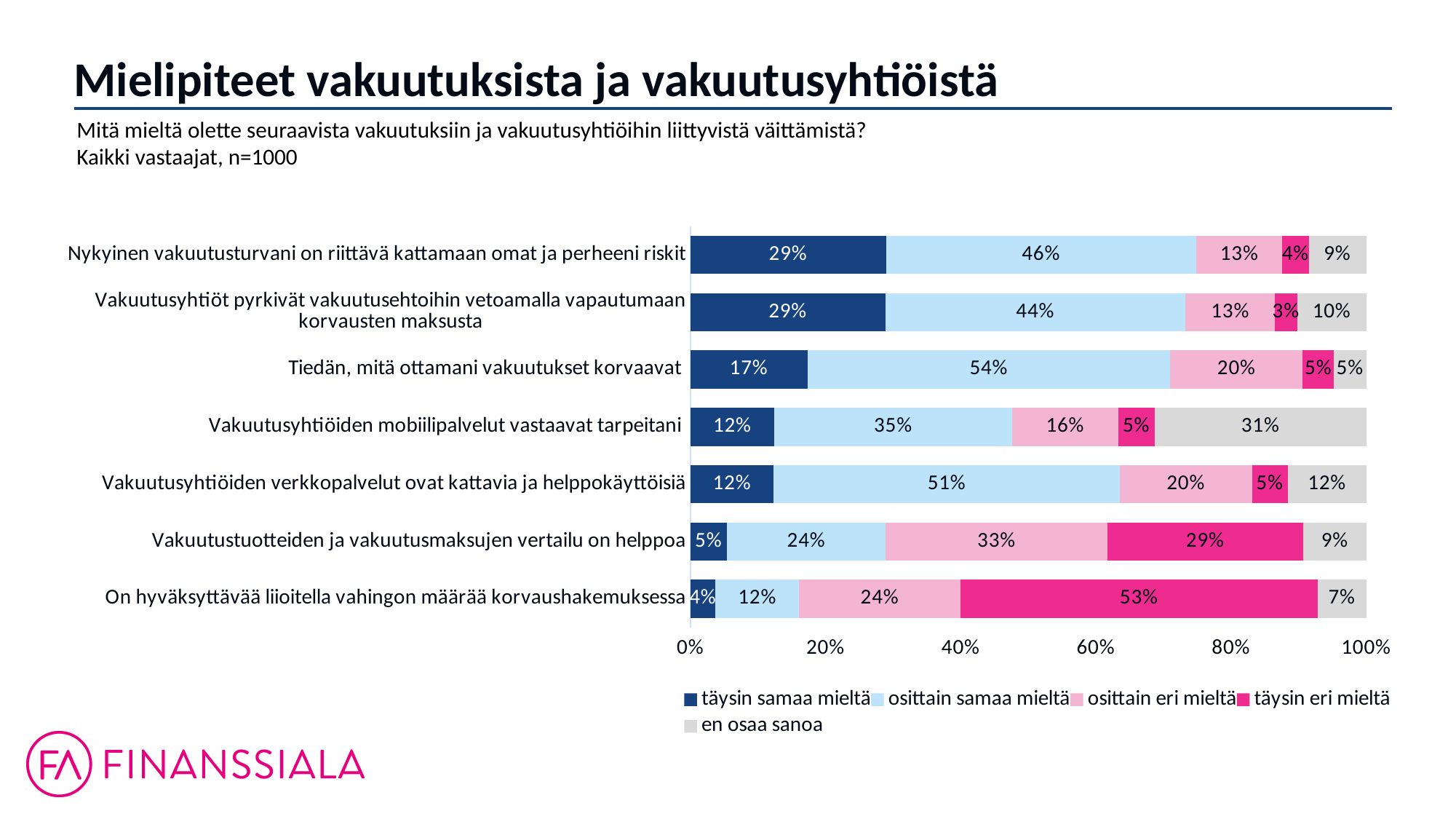
What is the 'osittain samaa mieltä' value for 'Vakuutusyhtiöiden verkkopalvelut ovat kattavia ja helppokäyttöisiä'? 51% How many statements are shown in the chart? 7 What kind of chart is shown on the slide? Stacked bar chart Which statement has the highest 'täysin eri mieltä' share? On hyväksyttävää liioitella vahingon määrää korvaushakemuksessa What is the 'en osaa sanoa' share for 'Vakuutusyhtiöiden mobiilipalvelut vastaavat tarpeitani'? 31% Which statement has the lowest 'täysin samaa mieltä' share? On hyväksyttävää liioitella vahingon määrää korvaushakemuksessa What is the difference between the 'osittain samaa mieltä' values for 'Tiedän, mitä ottamani vakuutukset korvaavat' and 'Vakuutustuotteiden ja vakuutusmaksujen vertailu on helppoa'? 30% What percentage are 'täysin eri mieltä' with 'On hyväksyttävää liioitella vahingon määrää korvaushakemuksessa'? 53% What is the sample size stated on the slide? n=1000 How many series does the legend list? 5 What percentage of respondents are 'täysin samaa mieltä' with 'Tiedän, mitä ottamani vakuutukset korvaavat'? 17% Which is larger: the 'osittain eri mieltä' share for 'Vakuutustuotteiden ja vakuutusmaksujen vertailu on helppoa' or for 'Nykyinen vakuutusturvani on riittävä kattamaan omat ja perheeni riskit'? Vakuutustuotteiden ja vakuutusmaksujen vertailu on helppoa